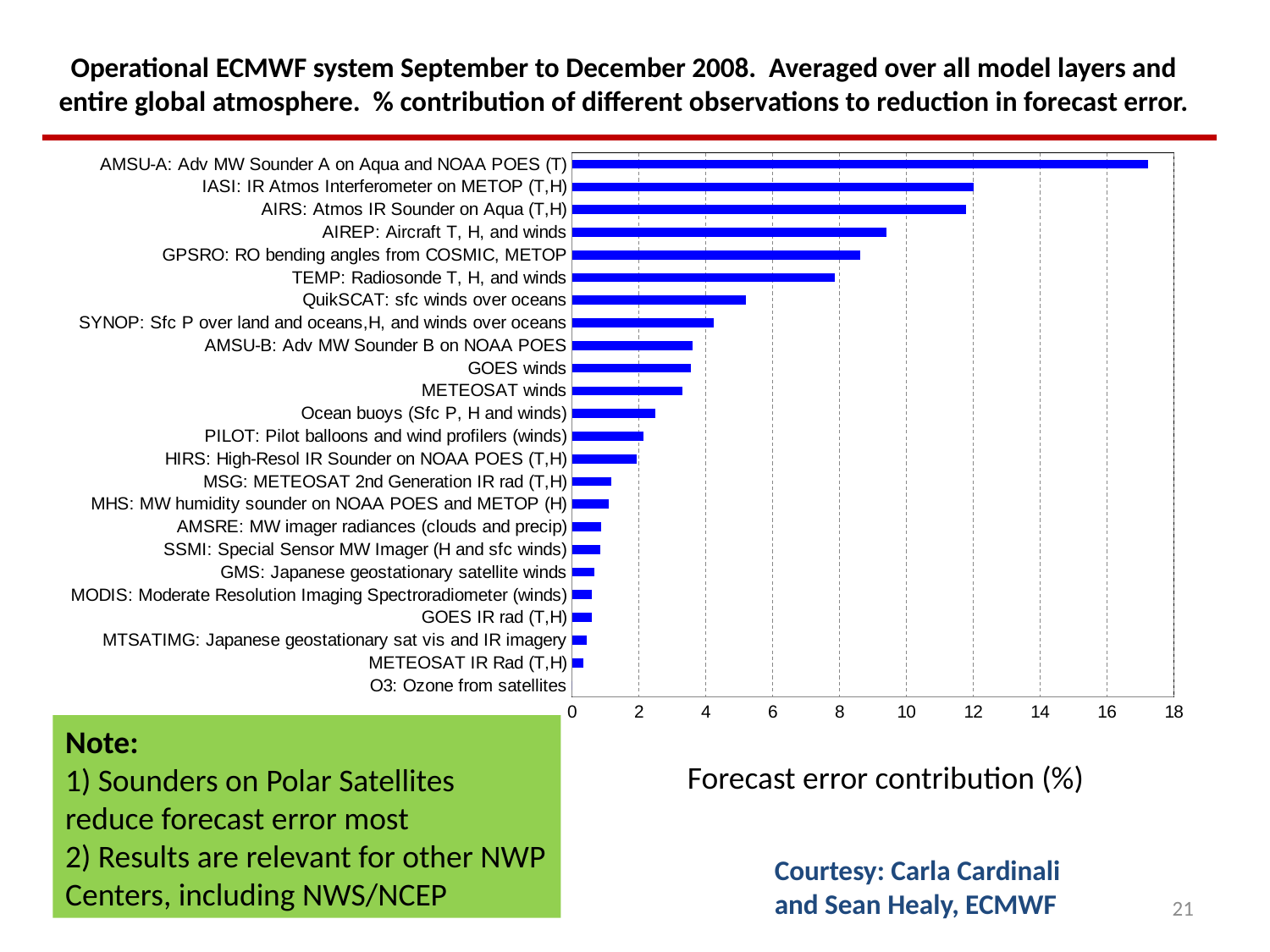
What is the label of the horizontal axis of the chart? Forecast error contribution (%) Which observation type has the highest forecast error contribution? AMSU-A: Adv MW Sounder A on Aqua and NOAA POES (T) Is the forecast error contribution for AIREP greater or less than 8? greater Is the forecast error contribution for QuikSCAT greater or less than 4? greater Is the forecast error contribution for MSG: METEOSAT 2nd Generation IR rad greater or less than 2? less Which has a larger forecast error contribution, QuikSCAT or SYNOP? QuikSCAT Which has a larger forecast error contribution, AIREP or GPSRO? AIREP How many observation types (bars) are listed in the chart? 24 Which observation type has the lowest forecast error contribution? O3: Ozone from satellites What kind of chart is shown on the slide? bar chart